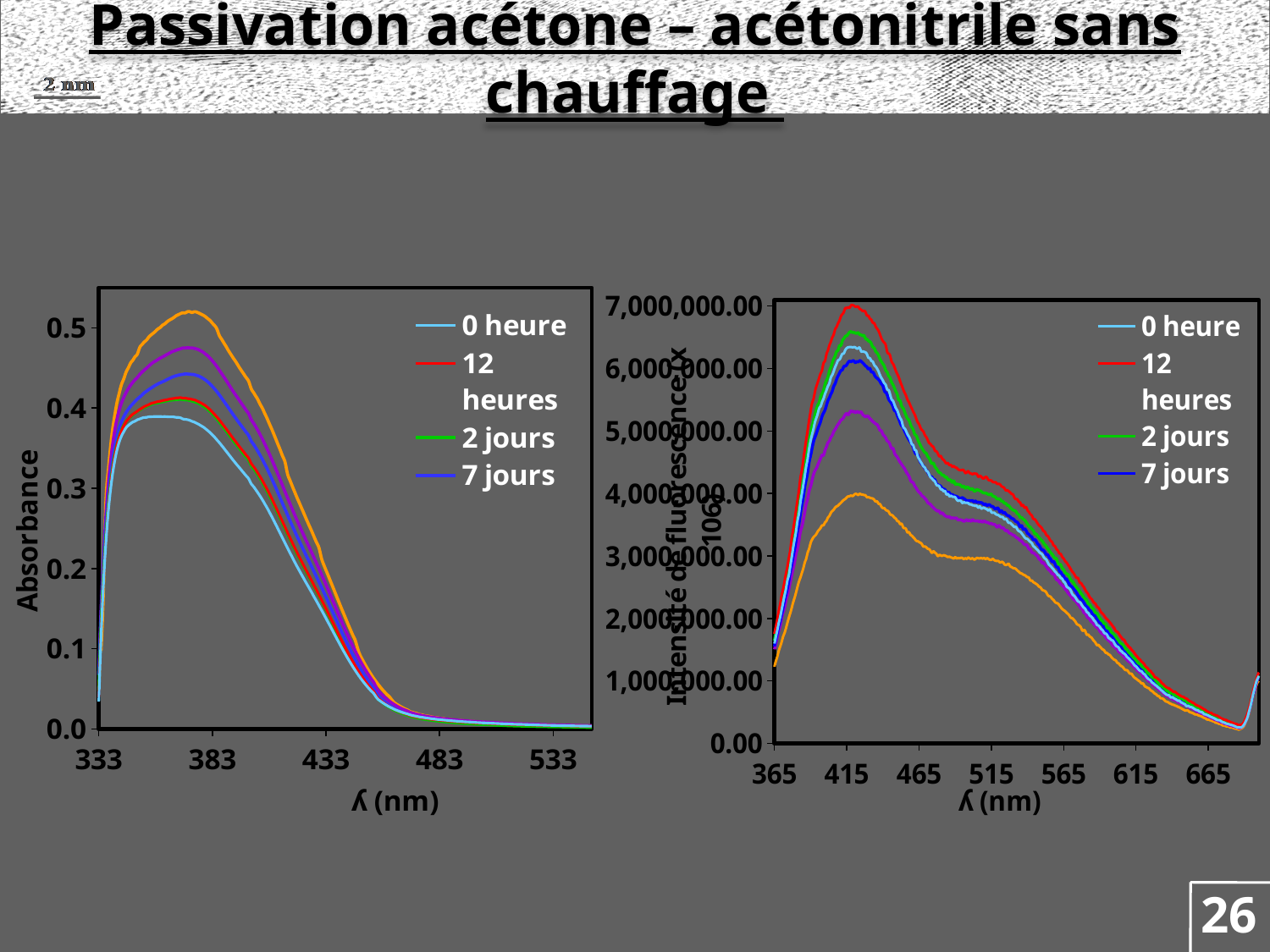
In the left chart, is the peak absorbance of the 0 heure series greater or less than 0.4? less In the right chart, which series reaches a higher peak intensity, 12 heures or 0 heure? 12 heures What is the label of the x axis on both charts? λ (nm) In the right chart, is the peak fluorescence intensity of the 0 heure series greater or less than 6,000,000.00? greater In the left chart, do the absorbance values rise or fall between 383 nm and 533 nm? fall What kind of chart is the left chart (Absorbance vs λ)? line chart In the left chart, how many series does the legend list? 4 In the right chart, how many series does the legend list? 4 What kind of chart is the right chart (Intensité de fluorescence vs λ)? line chart In the left chart, which series reaches a higher peak absorbance, 7 jours or 0 heure? 7 jours In the right chart, is the peak fluorescence intensity of the 2 jours series greater or less than 6,000,000.00? greater